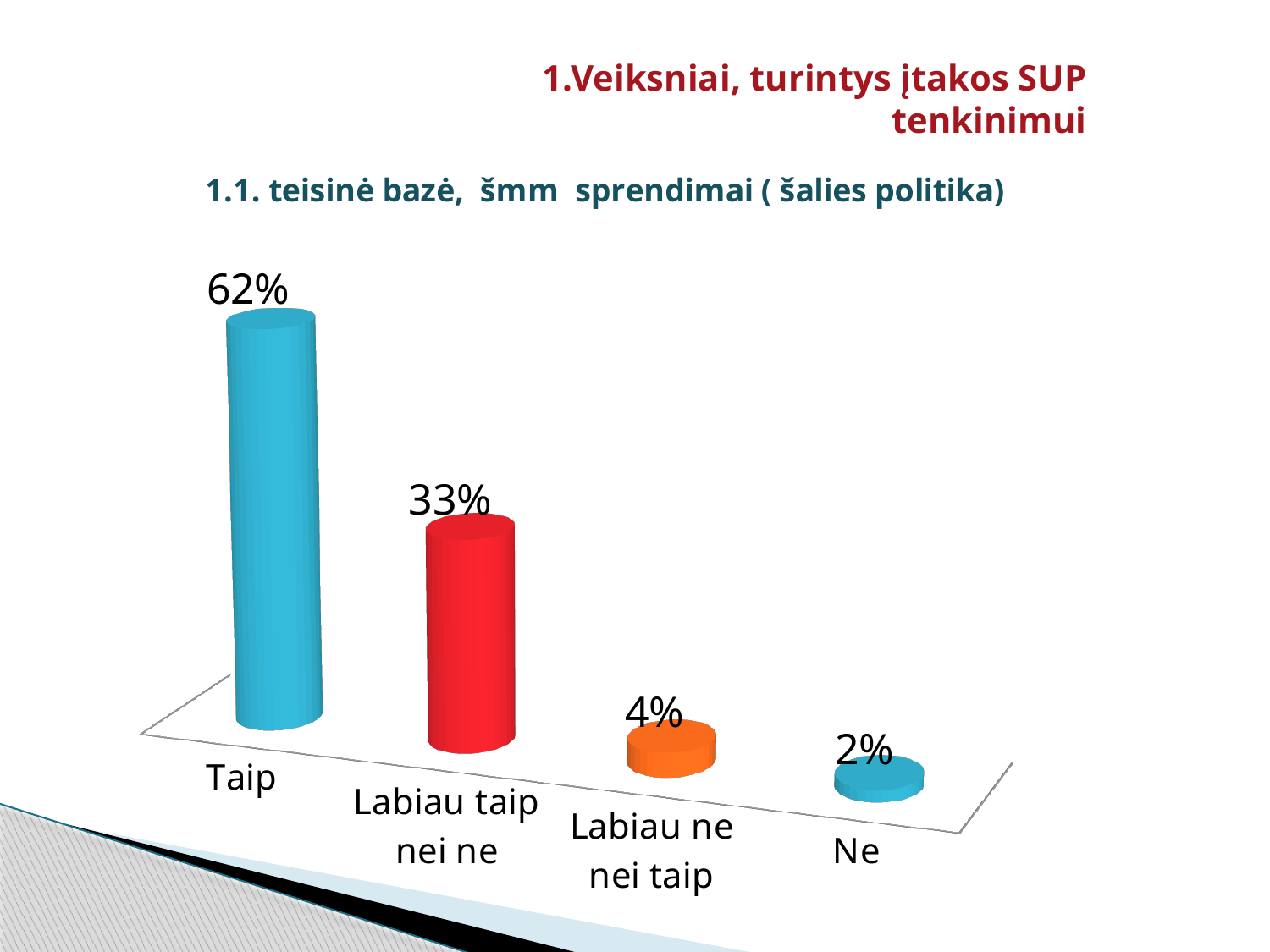
What kind of chart is shown on the slide? Bar chart Which category has the lowest value? Ne What is the value for "Labiau taip nei ne"? 33% What is the value for "Labiau ne nei taip"? 4% How many categories are shown in the chart? 4 What is the value for "Ne"? 2% Which category has the highest value? Taip What is the difference between the values for "Taip" and "Labiau taip nei ne"? 29% Which is larger, the value for "Labiau taip nei ne" or the value for "Labiau ne nei taip"? Labiau taip nei ne What is the value for "Taip"? 62% What is the difference between the values for "Labiau ne nei taip" and "Ne"? 2% Do the values rise or fall from left to right across the categories? Fall